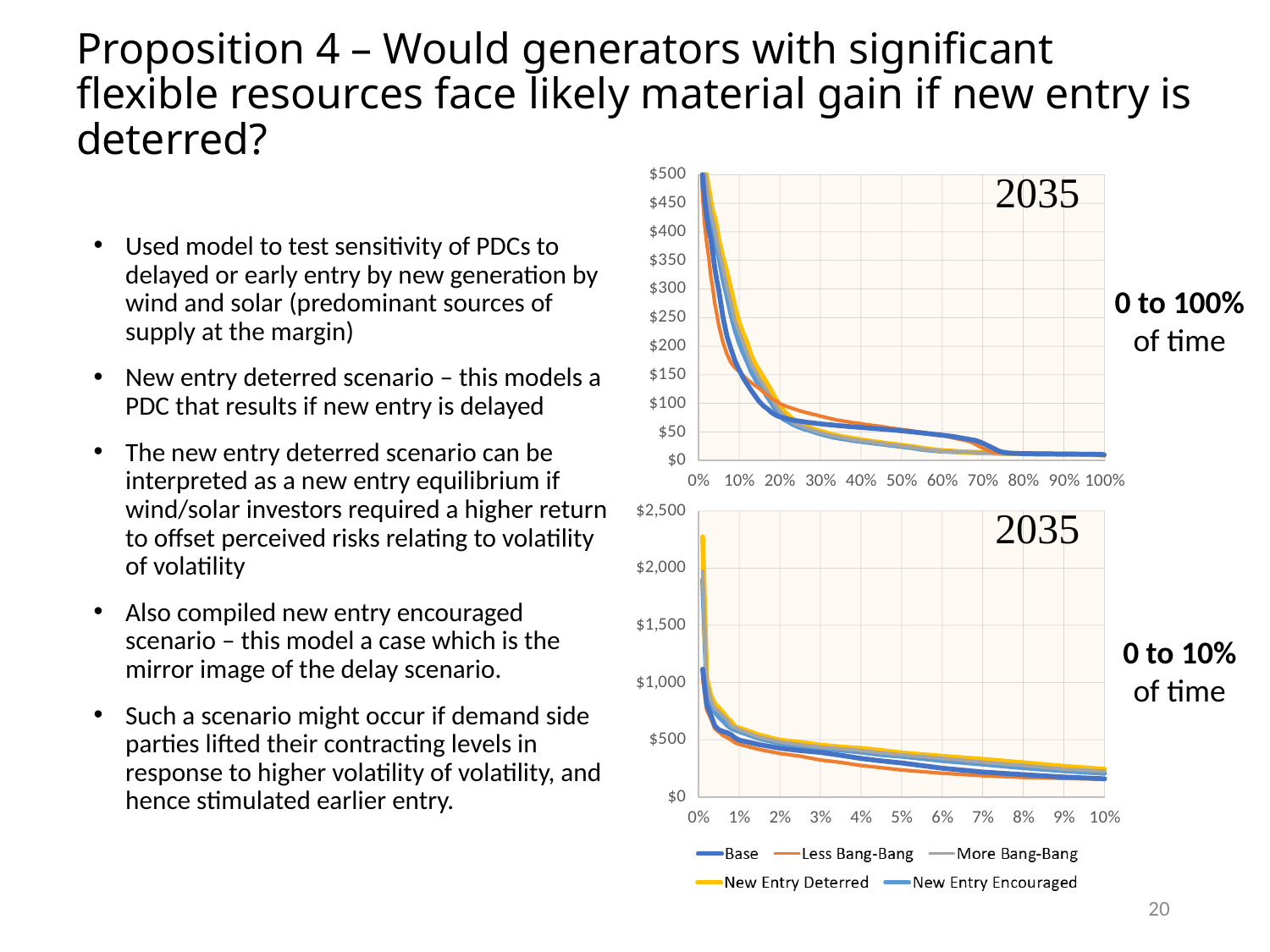
In the bottom chart (0 to 10% of time), is the peak value of the New Entry Deterred series greater or less than $2,000? greater What kind of chart is the bottom chart (0 to 10% of time)? line chart What kind of chart is the top chart (0 to 100% of time)? line chart In the bottom chart (0 to 10% of time), is the value of the Less Bang-Bang series at 5% of time greater or less than $500? less In the bottom chart (0 to 10% of time), do the values rise or fall as the percentage of time increases? fall In the top chart (0 to 100% of time), is the value of the Base series at 50% of time greater or less than $100? less How many series does the legend list for the charts? 5 What is the maximum value shown on the y axis of the bottom chart (0 to 10% of time)? $2,500 In the top chart (0 to 100% of time), do the values rise or fall as the percentage of time increases? fall What year is shown as the title on both charts? 2035 In the bottom chart (0 to 10% of time), which series has the higher value at 10% of time: New Entry Deterred or Less Bang-Bang? New Entry Deterred